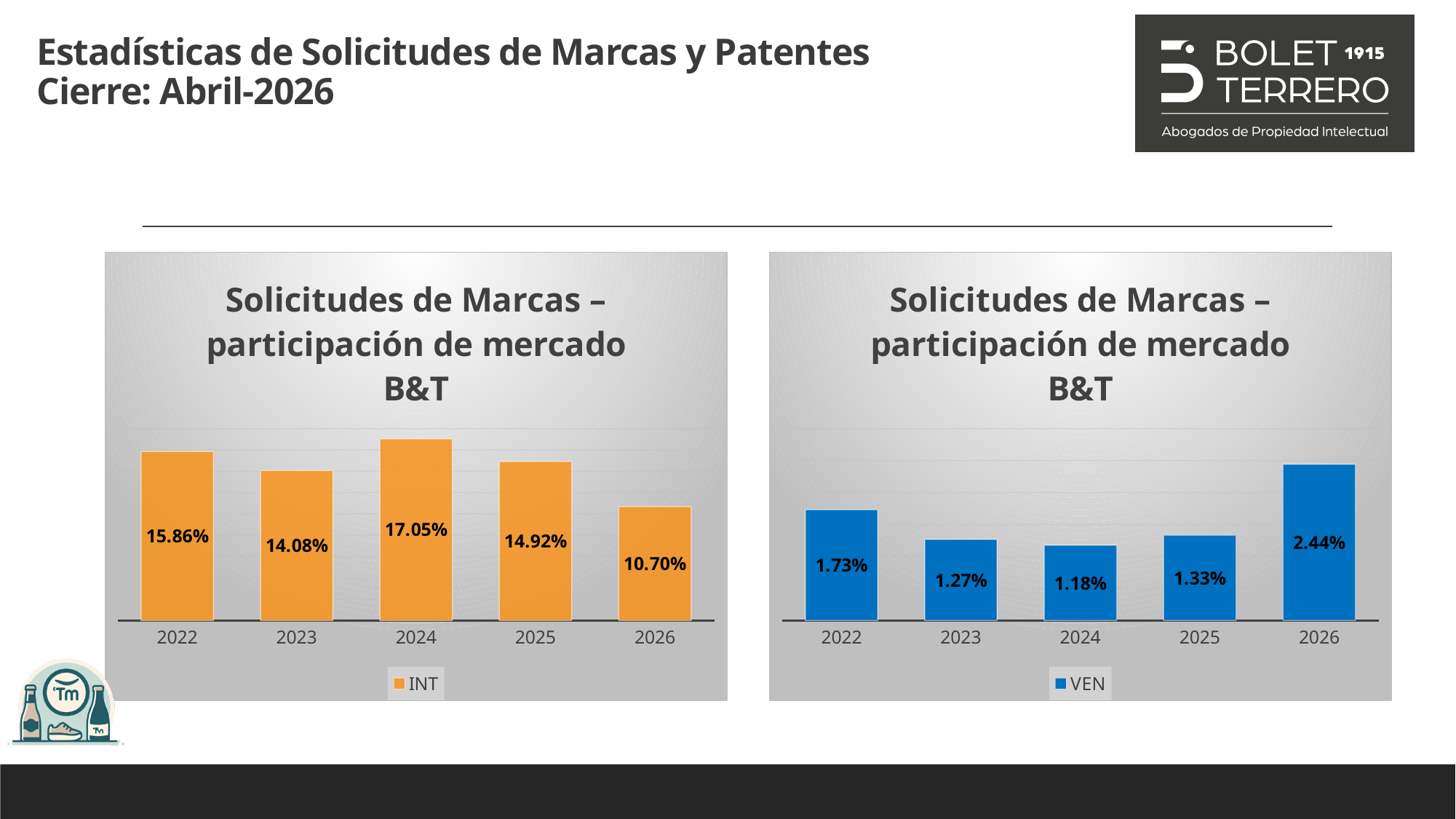
How many years are shown on the x axis of the left chart? 5 In the left chart (INT series), what is the value for 2024? 17.05% In the right chart (VEN series), which year has the lowest value? 2024 In the left chart (INT series), which is larger, the value for 2022 or the value for 2023? 2022 What series name does the legend of the left chart show? INT In the left chart (INT series), which year has the lowest value? 2026 In the left chart (INT series), what is the difference between the 2024 value and the 2026 value? 6.35% In the right chart (VEN series), which is larger, the value for 2025 or the value for 2023? 2025 In the right chart (VEN series), what is the difference between the 2026 value and the 2024 value? 1.26% In the right chart (VEN series), which year has the highest value? 2026 What kind of chart is the right chart (VEN series)? bar chart In the right chart (VEN series), what is the value for 2026? 2.44%